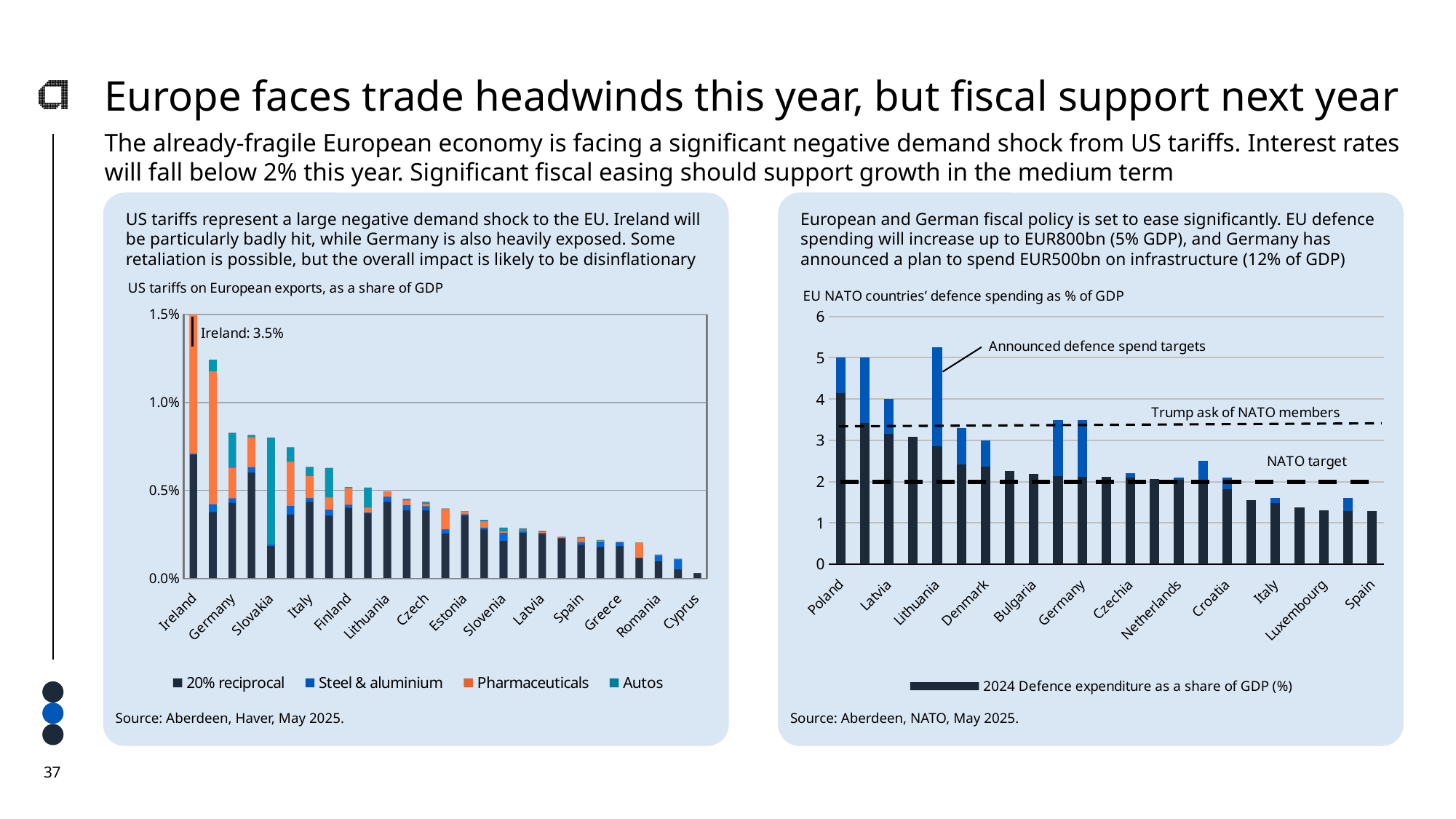
In the left chart, 'US tariffs on European exports, as a share of GDP', what value is annotated for Ireland? 3.5% In the right chart, 'EU NATO countries' defence spending as % of GDP', is the 2024 defence expenditure for Spain greater or less than 2? less What kind of chart is the left chart, 'US tariffs on European exports, as a share of GDP'? Stacked bar chart In the right chart, 'EU NATO countries' defence spending as % of GDP', which country has the highest 2024 defence expenditure as a share of GDP? Poland What kind of chart is the right chart, 'EU NATO countries' defence spending as % of GDP'? Bar chart In the right chart, 'EU NATO countries' defence spending as % of GDP', what do the two dashed horizontal lines represent? Trump ask of NATO members and NATO target In the left chart, 'US tariffs on European exports, as a share of GDP', is the value for Cyprus greater or less than 0.5%? less In the left chart, 'US tariffs on European exports, as a share of GDP', which series is shown in orange? Pharmaceuticals In the left chart, 'US tariffs on European exports, as a share of GDP', which country has the highest value? Ireland In the left chart, 'US tariffs on European exports, as a share of GDP', which labelled country has the lowest value? Cyprus How many series does the legend of the left chart, 'US tariffs on European exports, as a share of GDP', list? 4 In the left chart, 'US tariffs on European exports, as a share of GDP', do the values rise or fall moving from left to right along the x axis? fall